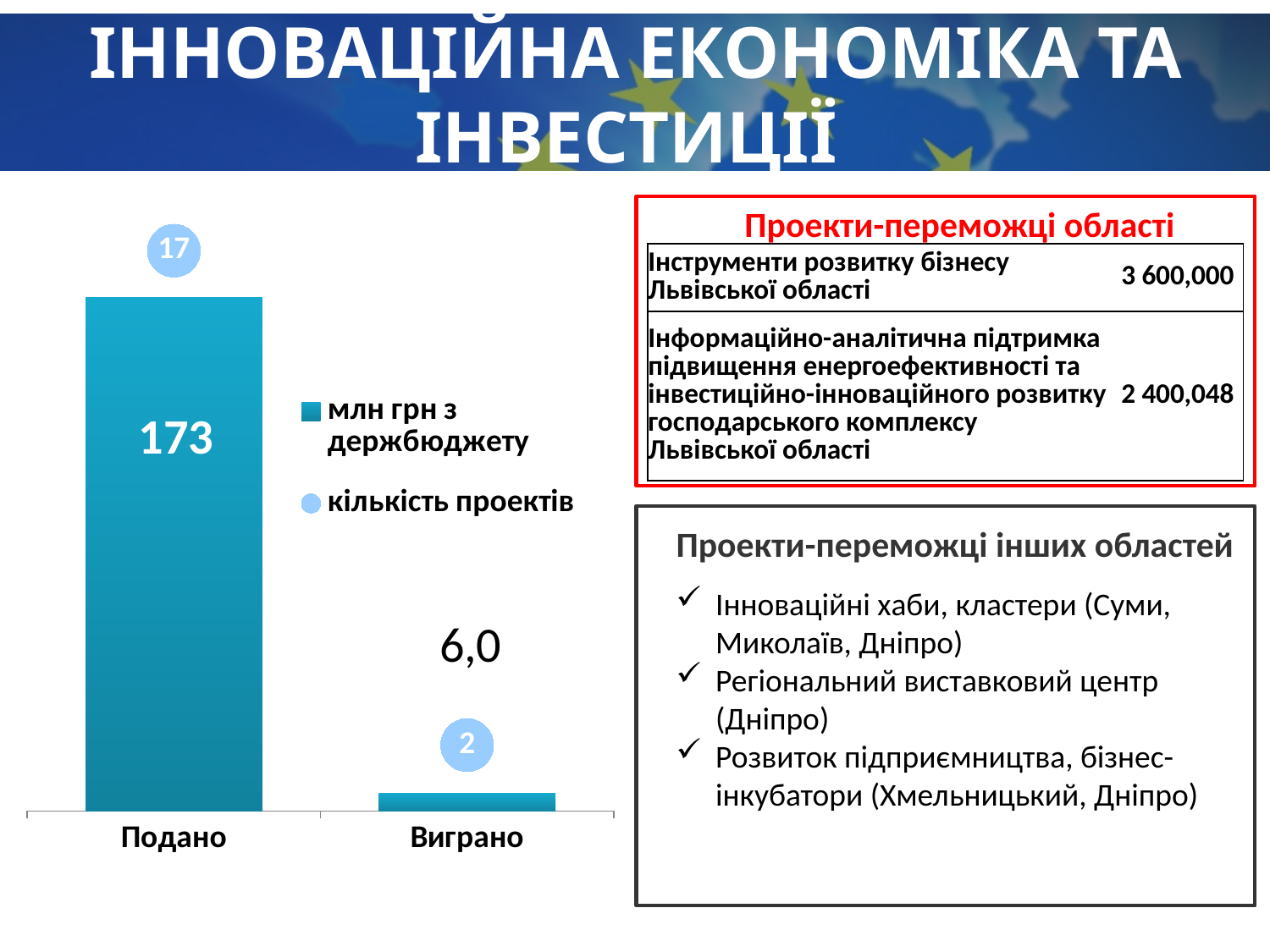
How many series does the chart legend list? 2 What are the two series names listed in the chart legend? млн грн з держбюджету; кількість проектів Is the "млн грн з держбюджету" value for "Подано" larger or smaller than for "Виграно"? larger What is the value of "млн грн з держбюджету" for "Подано"? 173 Which category has the lower value for "кількість проектів"? Виграно What is the difference in "кількість проектів" between "Подано" and "Виграно"? 15 What is the value of "кількість проектів" for "Виграно"? 2 Which category has the higher value for "млн грн з держбюджету"? Подано How many categories are shown on the x axis of the chart? 2 What is the value of "кількість проектів" for "Подано"? 17 What is the value of "млн грн з держбюджету" for "Виграно"? 6,0 What kind of chart is shown on the slide? combination bar and line chart